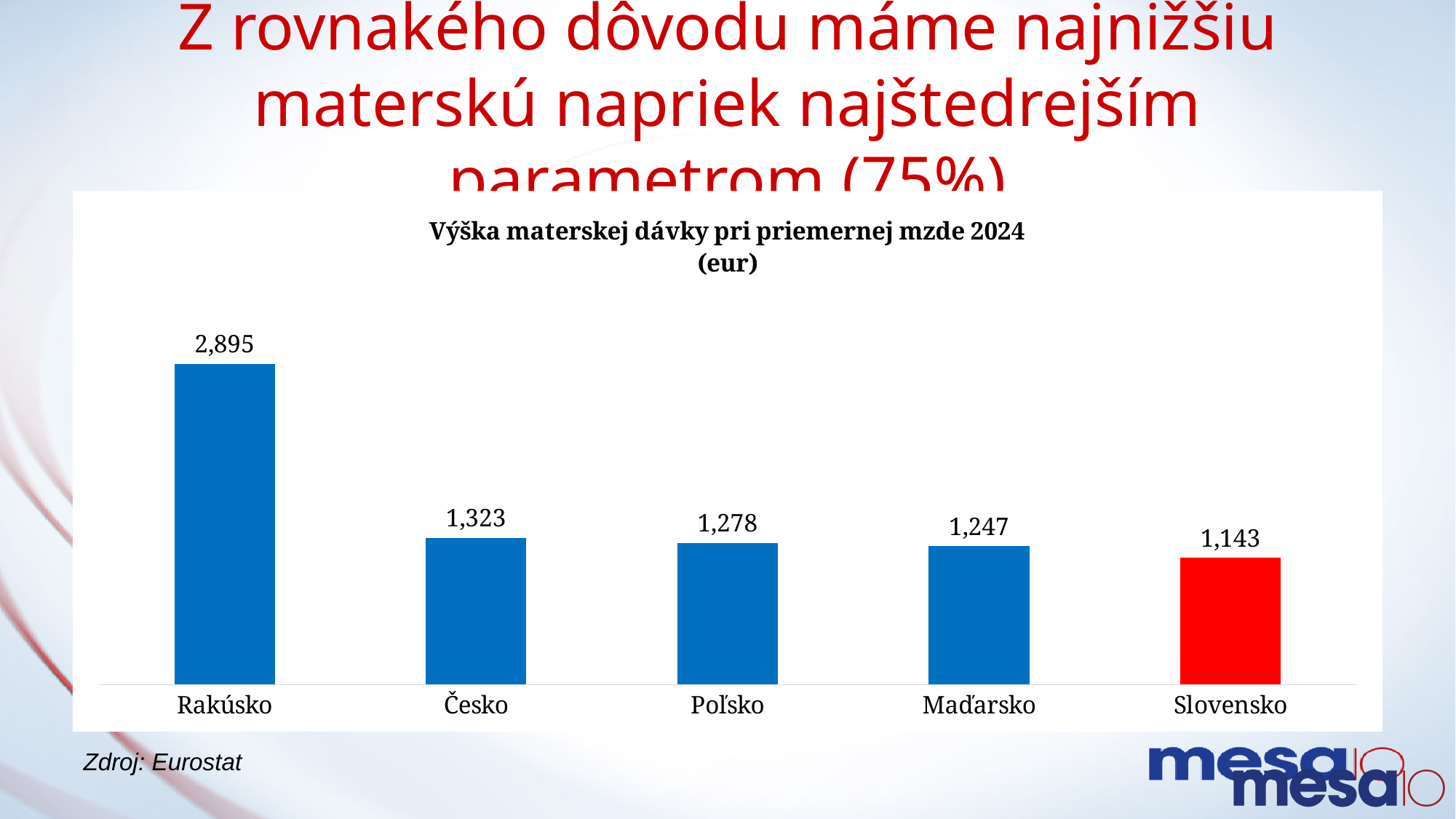
Which country has the lowest value? Slovensko What kind of chart is shown? Bar chart What is the value for Slovensko? 1,143 What is the value for Poľsko? 1,278 Which bar is coloured red instead of blue? Slovensko What is the difference between the values for Rakúsko and Slovensko? 1,752 What is the value for Maďarsko? 1,247 What is the value for Rakúsko? 2,895 What is the difference between the values for Česko and Poľsko? 45 Which country has the highest value? Rakúsko How many countries are shown in the chart? 5 Which is larger, the value for Česko or the value for Maďarsko? Česko